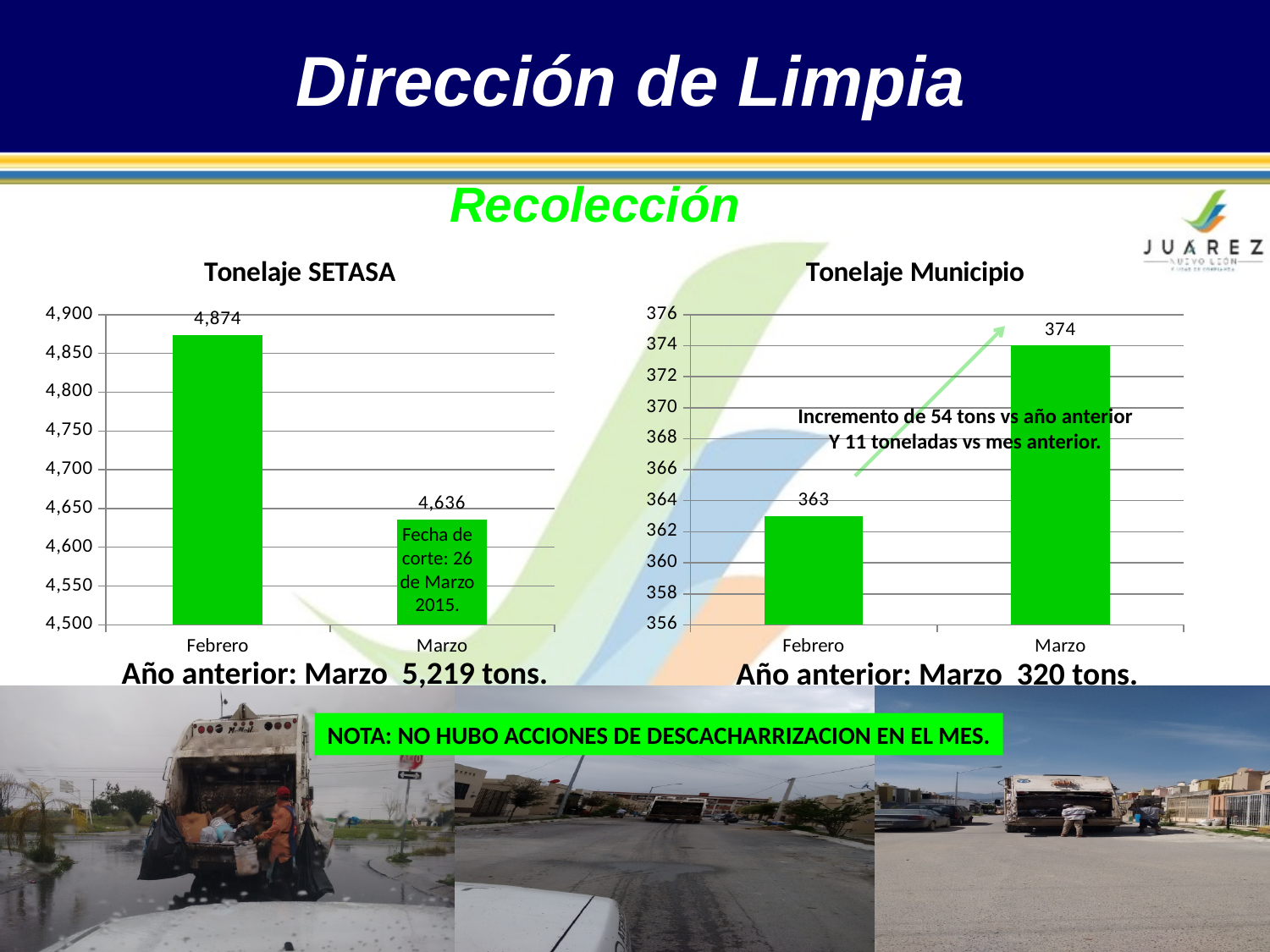
In the Tonelaje SETASA chart, what is the difference between the Febrero and Marzo values? 238 What kind of chart is the Tonelaje SETASA chart? bar chart In the Tonelaje Municipio chart, what is the value for Marzo? 374 In the Tonelaje Municipio chart, is the value for Marzo greater or less than 370? greater In the Tonelaje Municipio chart, do the values rise or fall from Febrero to Marzo? rise In the Tonelaje SETASA chart, which month has the higher value? Febrero In the Tonelaje SETASA chart, what is the value for Febrero? 4,874 In the Tonelaje Municipio chart, what is the value for Febrero? 363 In the Tonelaje Municipio chart, which month has the lower value? Febrero In the Tonelaje SETASA chart, what is the value for Marzo? 4,636 In the Tonelaje Municipio chart, what is the difference between the Marzo and Febrero values? 11 How many categories are shown in the Tonelaje SETASA chart? 2